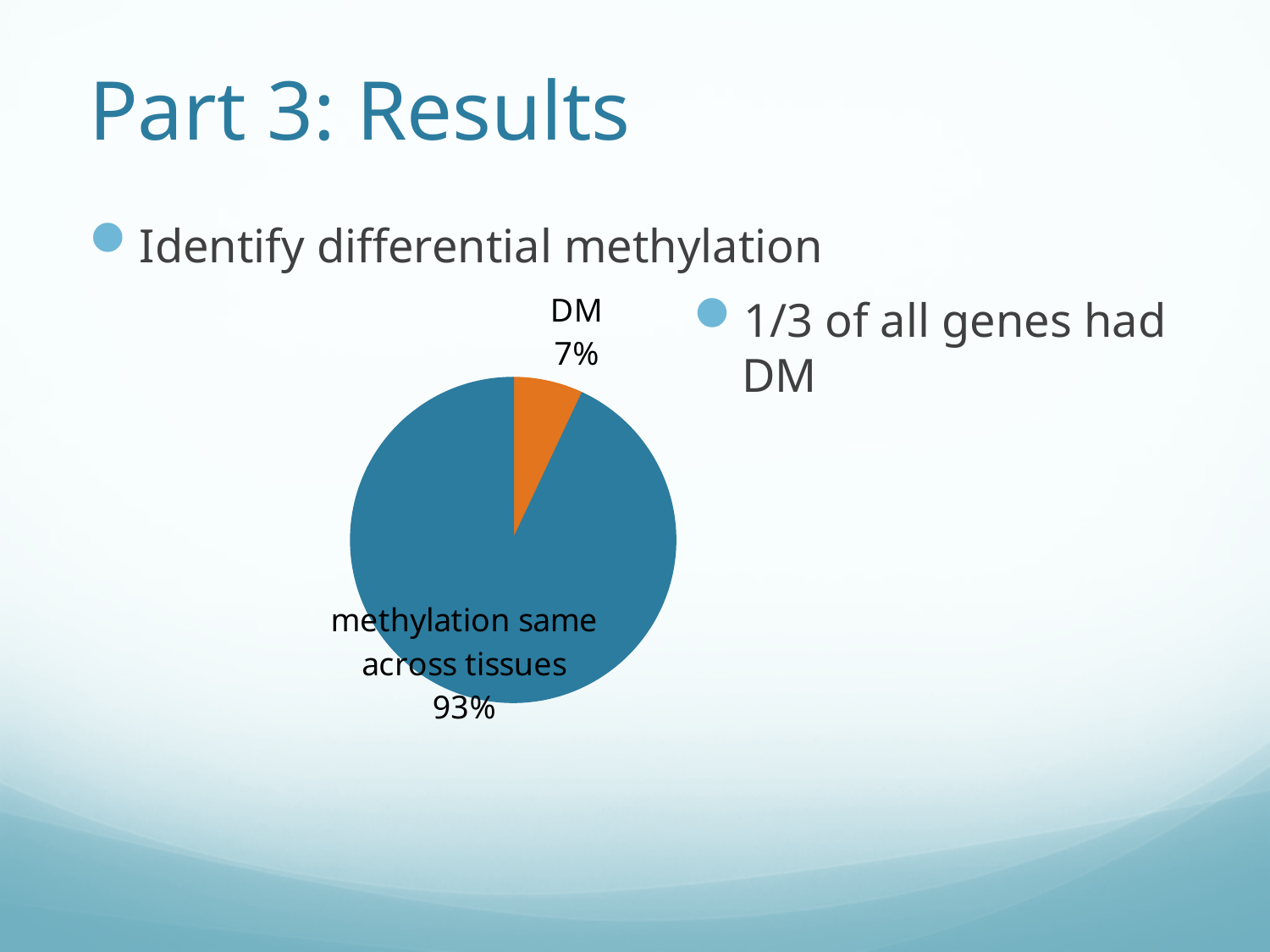
How many slices does the pie chart have? 2 Which is larger, the DM slice or the 'methylation same across tissues' slice? methylation same across tissues Which slice of the pie is the smallest? DM Which slice of the pie is the largest? methylation same across tissues What is the difference in percentage points between the 'methylation same across tissues' slice and the DM slice? 86 What percentage of the pie is labelled 'methylation same across tissues'? 93% What share of the pie does the DM slice represent? 7% What colour is the DM slice of the pie? orange What colour is the 'methylation same across tissues' slice of the pie? blue What percentage of the pie is labelled DM? 7% What kind of chart is shown on the slide? pie chart